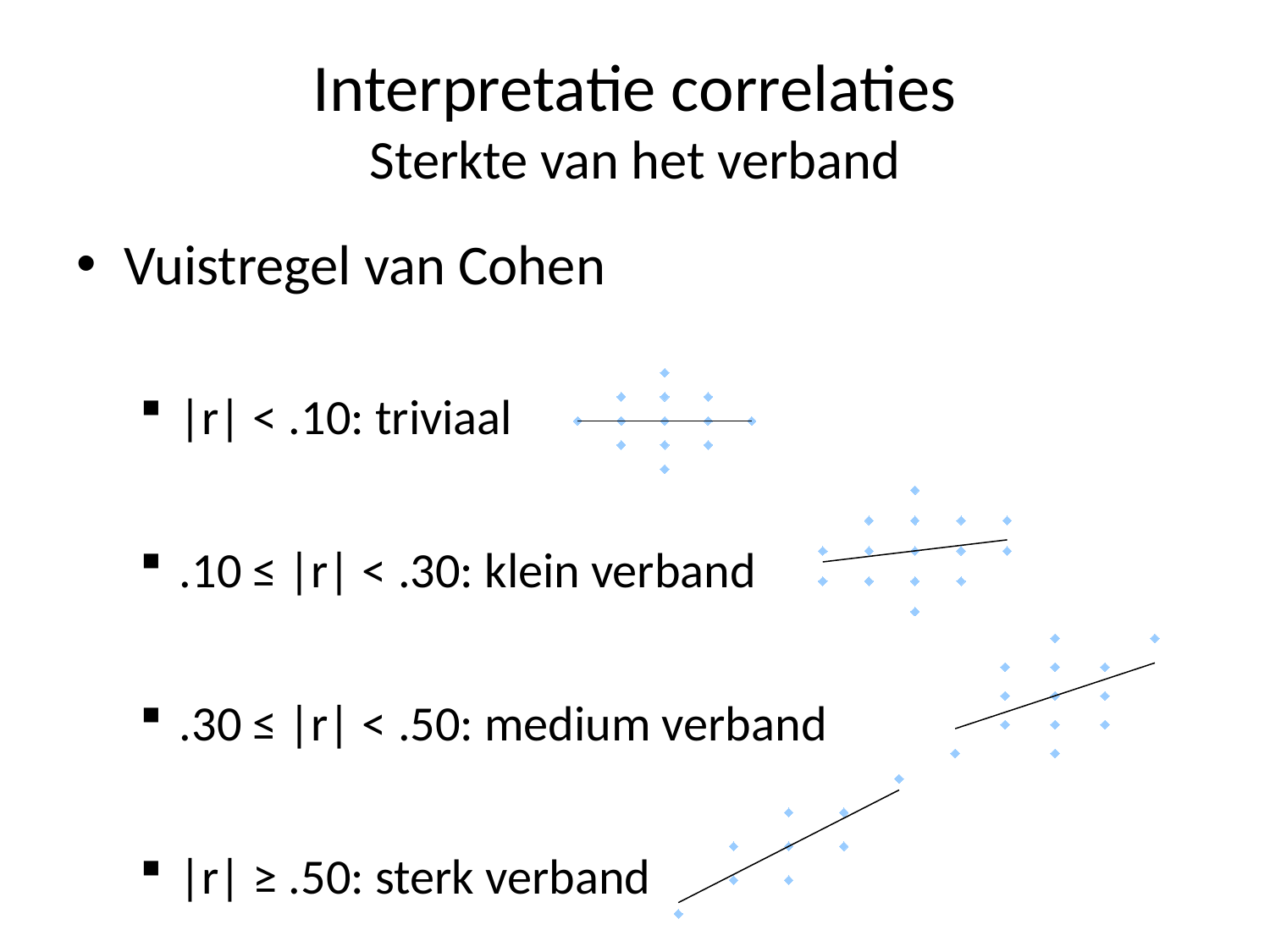
What kind of chart is shown next to the bullet "|r| < .10: triviaal"? scatter chart What colour are the data points in the scatter charts? light blue In the chart next to "|r| < .10: triviaal", is the trend line rising, falling or flat? flat Which of the four scatter charts has the flattest trend line? the one next to "|r| < .10: triviaal" Do the scatter charts on the slide show axis labels or numeric values? no Which of the four scatter charts has the steepest trend line? the one next to "|r| ≥ .50: sterk verband" In the chart next to "|r| ≥ .50: sterk verband", does the trend line rise or fall from left to right? rise How many scatter charts are shown on the slide? 4 In the chart next to ".30 ≤ |r| < .50: medium verband", does the trend line rise or fall from left to right? rise